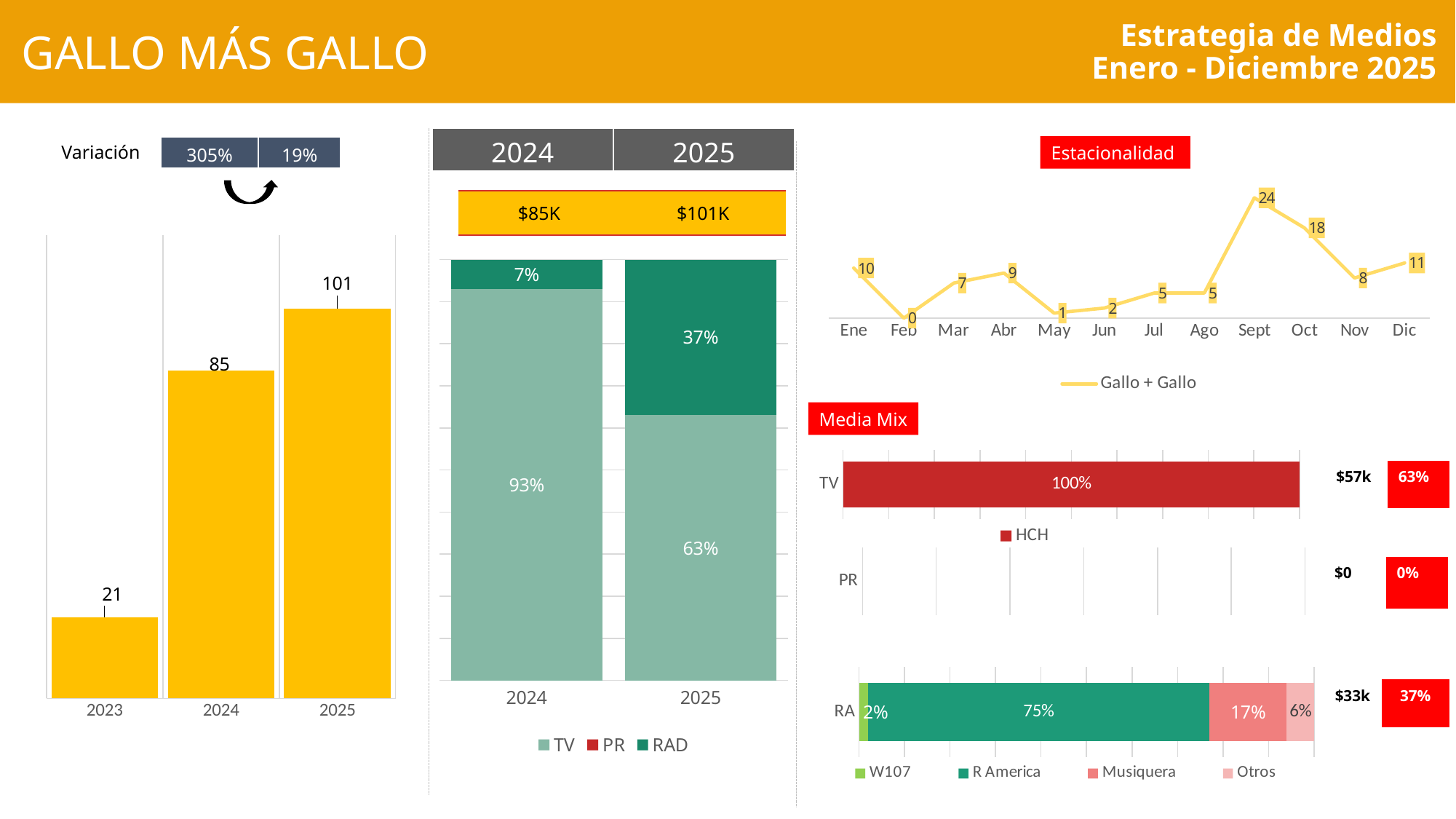
In the Estacionalidad line chart, how many months are plotted on the x axis? 12 In the left bar chart, what is the difference between the values for 2024 and 2023? 64 In the Estacionalidad line chart, which month has the highest value? Sept In the Media Mix chart, which is larger in the RA bar: Musiquera or Otros? Musiquera In the middle stacked bar chart, what is the TV share for 2024? 93% What type of chart is the left chart showing 2023, 2024 and 2025? Bar chart In the Estacionalidad line chart, what is the value for Oct? 18 In the Media Mix chart, what is the share of R America in the RA bar? 75% In the left bar chart, what is the value for 2025? 101 In the middle stacked bar chart, what is the RAD share for 2025? 37% How many series does the legend of the middle stacked bar chart list? 3 In the left bar chart, which year has the lowest value? 2023